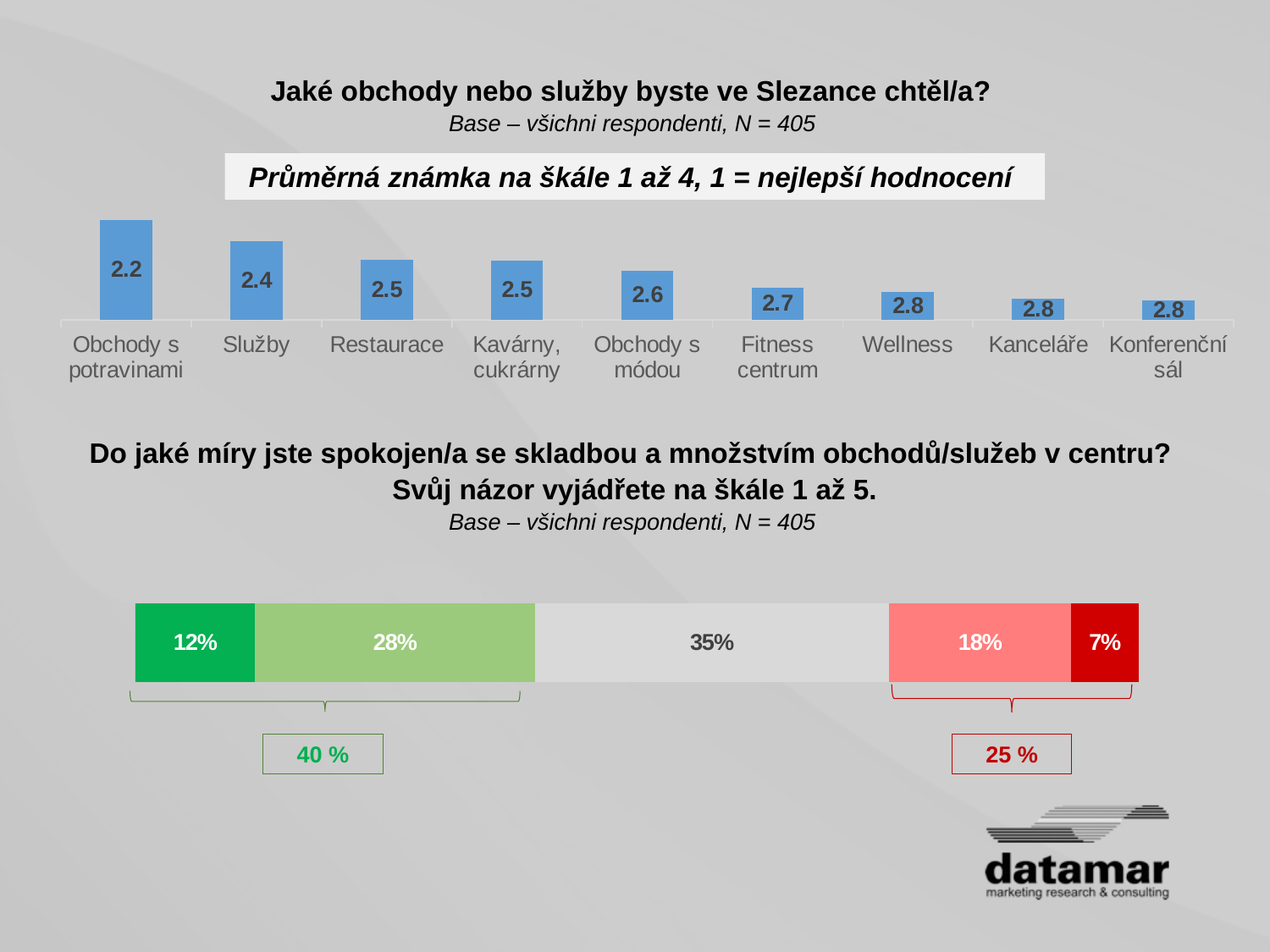
In the bottom stacked bar, what percentage is shown in the middle grey segment? 35% In the top bar chart, which has the larger value, Služby or Obchody s módou? Obchody s módou In the bottom stacked bar, what is the difference between the 18% segment and the 7% segment? 11% What kind of chart is the top chart on the slide? Bar chart In the top bar chart, what is the average rating for Restaurace? 2.5 In the bottom stacked bar, what is the combined share shown for the two green segments? 40 % In the top bar chart, which category has the lowest value? Obchody s potravinami How many categories are shown in the top bar chart? 9 In the top bar chart, what is the difference between the values for Fitness centrum and Obchody s potravinami? 0.5 In the top bar chart, what is the value shown for Wellness? 2.8 In the top bar chart, do the values rise or fall from left to right? Rise How many segments does the bottom stacked bar contain? 5